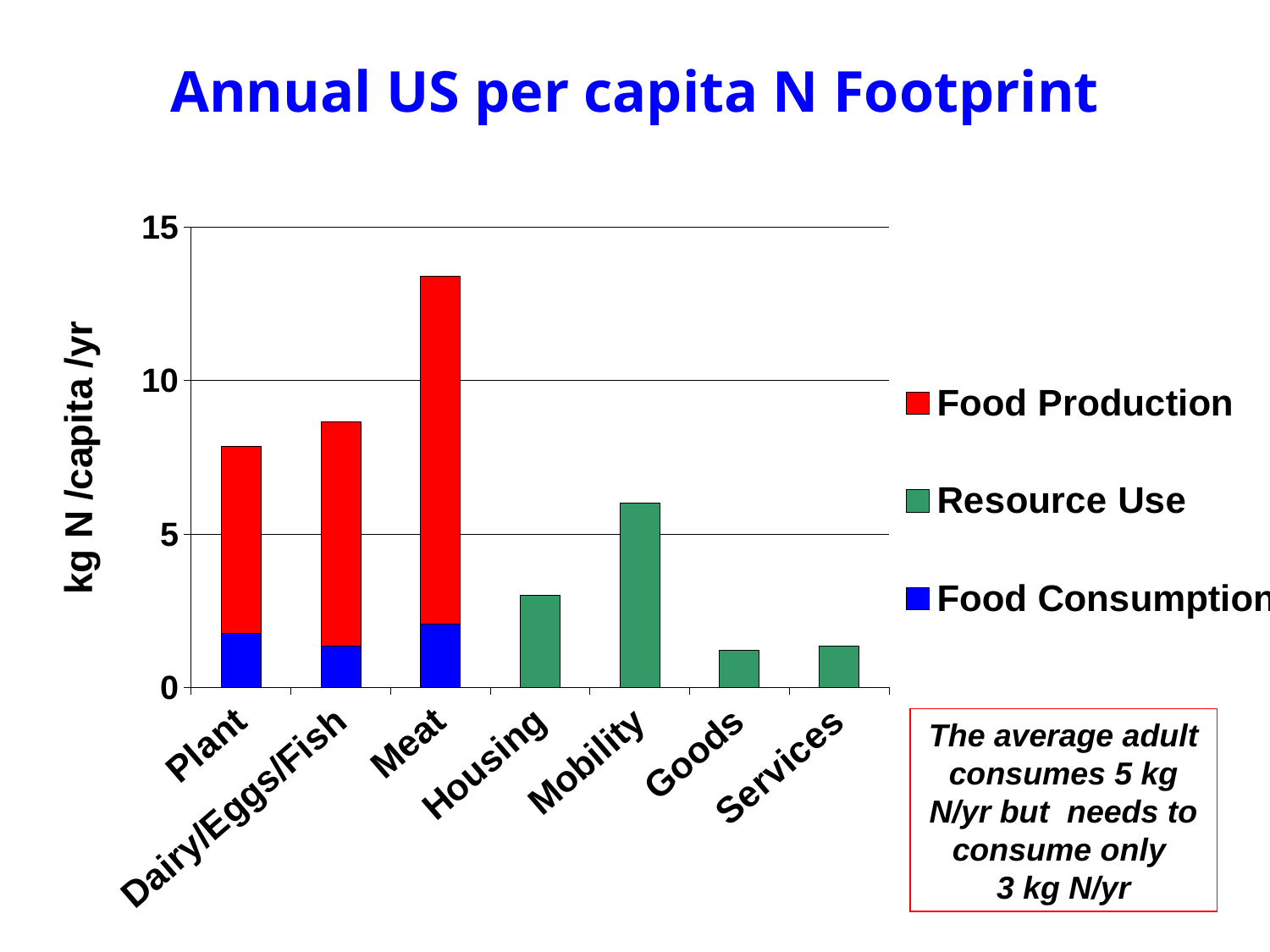
Is the total value for Meat greater or less than 10? greater What kind of chart is shown on the slide? bar chart Which series is shown in green in the chart's legend? Resource Use Which has a larger value, Mobility or Housing? Mobility How many series does the chart's legend list? 3 How many categories are shown on the x axis of the chart? 7 Which has a larger total bar, Dairy/Eggs/Fish or Plant? Dairy/Eggs/Fish What is the title of the chart on the slide? Annual US per capita N Footprint Is the total value for Plant greater or less than 5? greater Is the value for Housing greater or less than 5? less Which category has the highest total bar in the chart? Meat